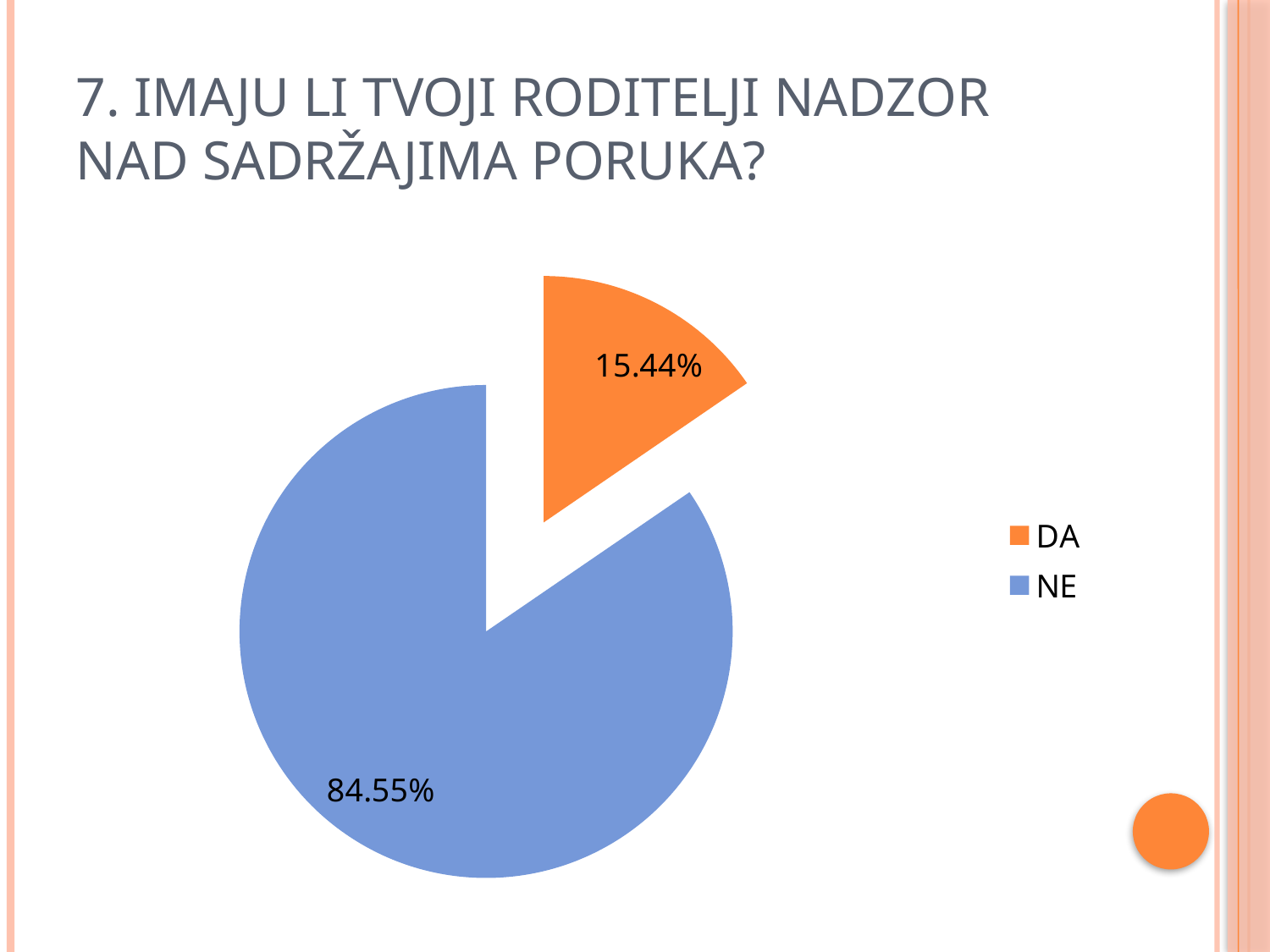
Which category has the largest slice of the pie? NE What colour is the NE slice? blue Which category has the smallest slice of the pie? DA What share of the pie does NE represent? 84.55% What colour is the DA slice? orange How many slices does the pie chart have? 2 What is the difference between the NE share and the DA share? 69.11% What share of the pie does DA represent? 15.44% What kind of chart is shown on the slide? pie chart Which is larger, the share for DA or the share for NE? NE How many entries does the legend list? 2